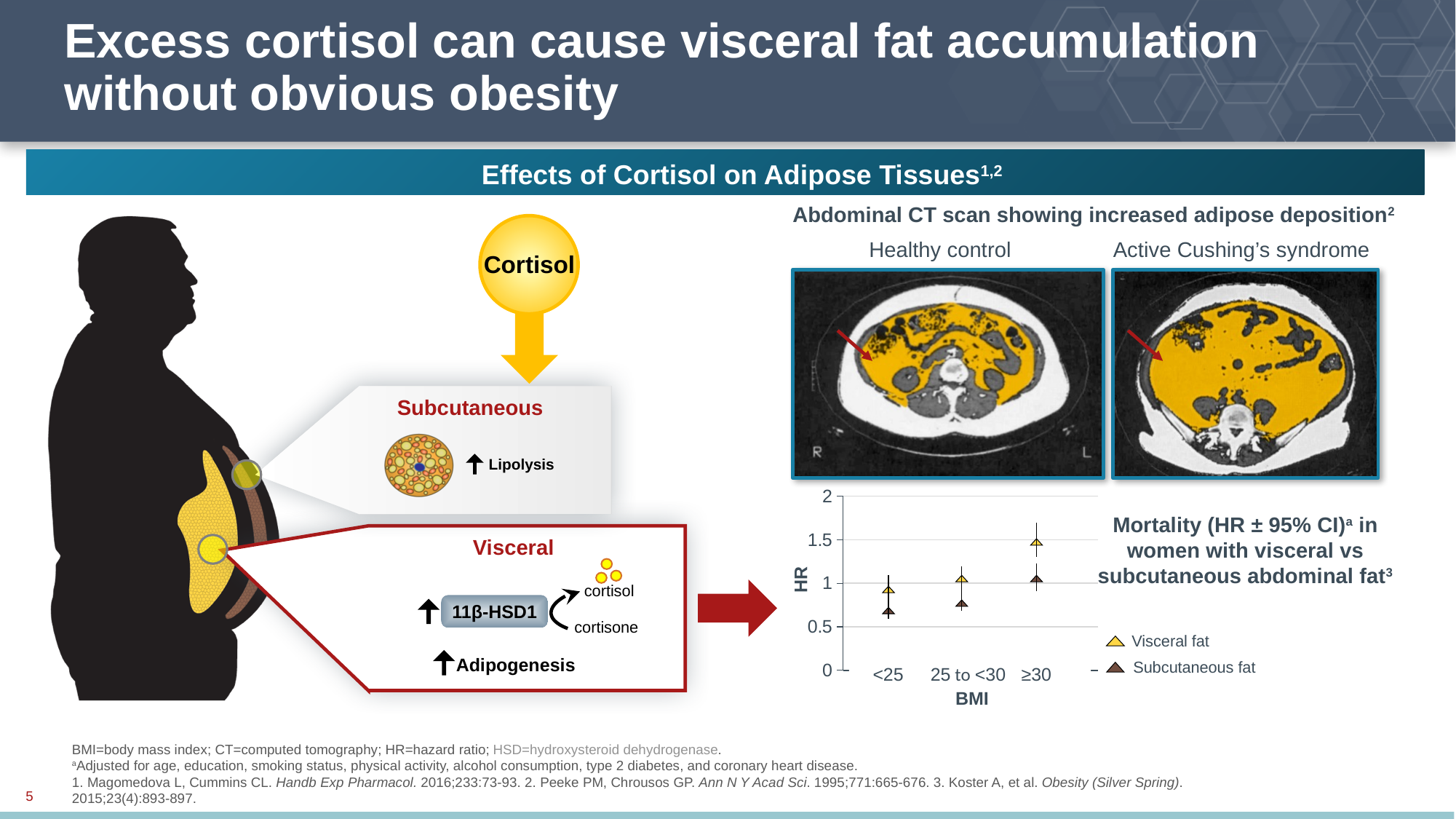
What is the label on the y axis of the mortality chart? HR In the mortality chart, is the HR for subcutaneous fat at BMI 25 to <30 greater or less than 1? less In the mortality chart, is the HR for visceral fat at BMI ≥30 greater or less than 1? greater In the mortality chart, which BMI category has the highest HR for visceral fat? ≥30 In the mortality chart, at BMI ≥30, which series has the higher HR: visceral fat or subcutaneous fat? Visceral fat In the mortality chart, is the HR for subcutaneous fat at BMI <25 greater or less than 1? less In the mortality chart, does the HR for visceral fat rise or fall as BMI increases? rise In the mortality chart, which BMI category has the lowest HR for subcutaneous fat? <25 How many series does the legend of the mortality chart list? 2 What kind of chart is the Mortality (HR ± 95% CI) chart? scatter chart What are the two legend entries in the mortality chart? Visceral fat, Subcutaneous fat How many BMI categories are shown on the x axis of the mortality chart? 3